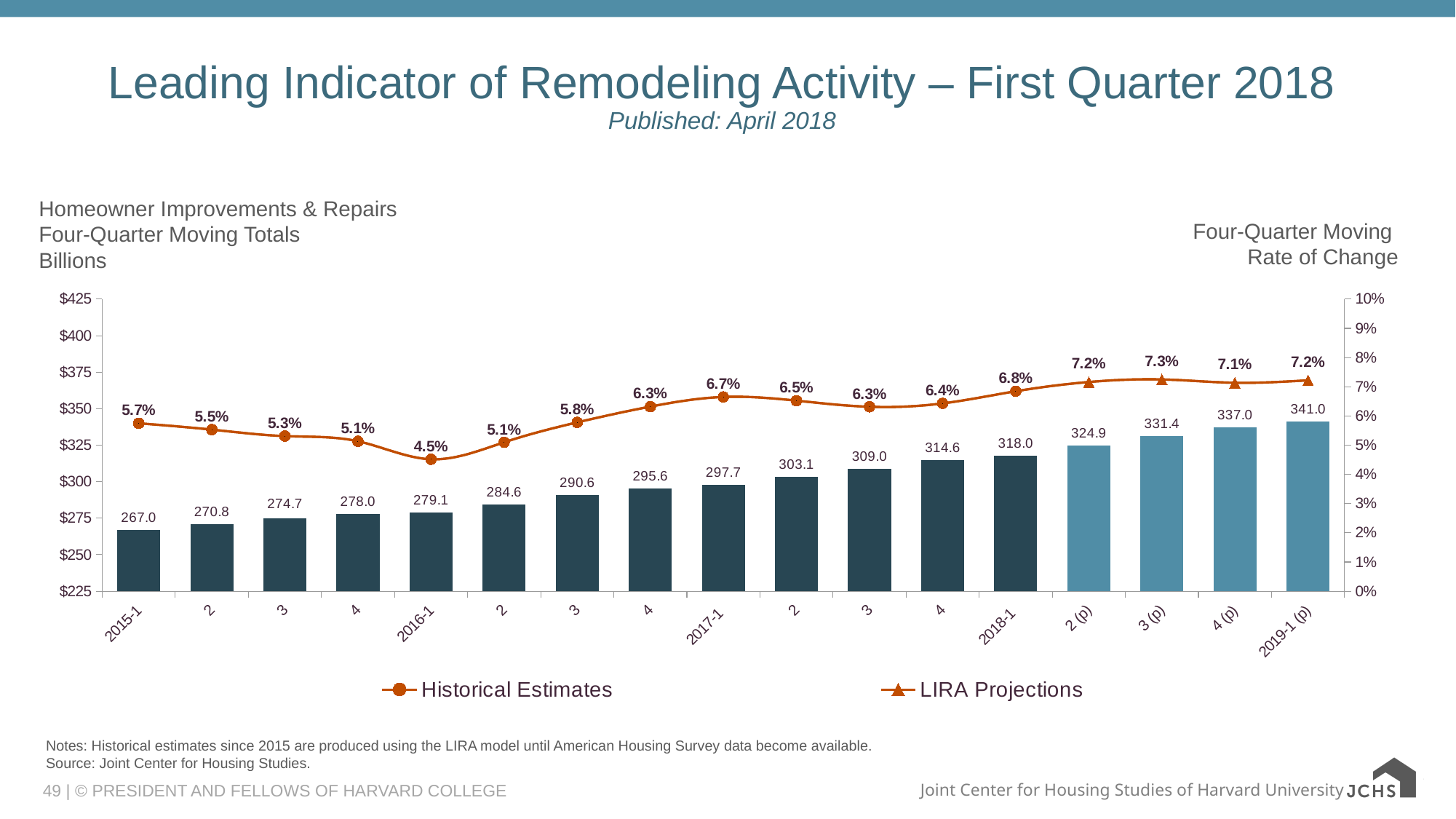
What kind of chart is shown on the slide? Combined bar and line chart Which quarter has the highest four-quarter moving total? 2019-1 (p) How many series does the legend list? 2 How many quarters are shown on the x axis? 17 What are the two entries in the chart legend? Historical Estimates and LIRA Projections Do the four-quarter moving totals rise or fall from 2015-1 to 2019-1 (p)? Rise Which quarter has the lowest four-quarter moving rate of change? 2016-1 Which has a higher rate of change, 2016-1 or 2017-1? 2017-1 What is the four-quarter moving rate of change for 2016-1? 4.5% What is the projected four-quarter moving total for 2019-1 (p)? 341.0 What is the difference between the four-quarter moving totals for 2019-1 (p) and 2018-1? 23.0 What is the four-quarter moving total for 2017-1? 297.7